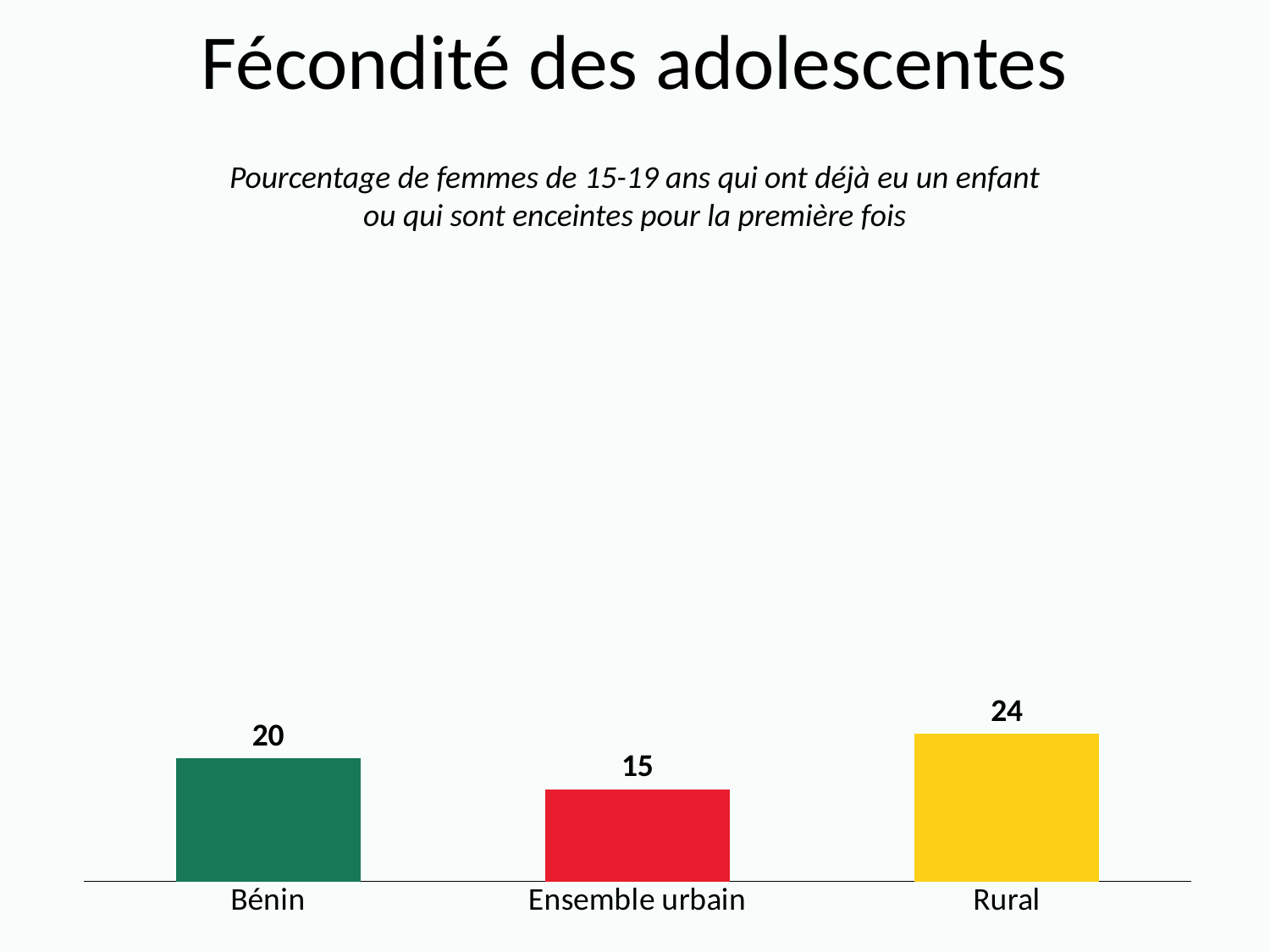
What is the value for Rural? 24 What is the difference between the values for Rural and Ensemble urbain? 9 What is the value for Bénin? 20 What is the title of the slide? Fécondité des adolescentes What kind of chart is shown on the slide? Bar chart What colour is the bar for Rural? Yellow What is the value for Ensemble urbain? 15 Which category has the lowest value? Ensemble urbain How many categories are shown in the chart? 3 Which category has the highest value? Rural What is the difference between the values for Bénin and Ensemble urbain? 5 Which is larger, the value for Bénin or the value for Rural? Rural